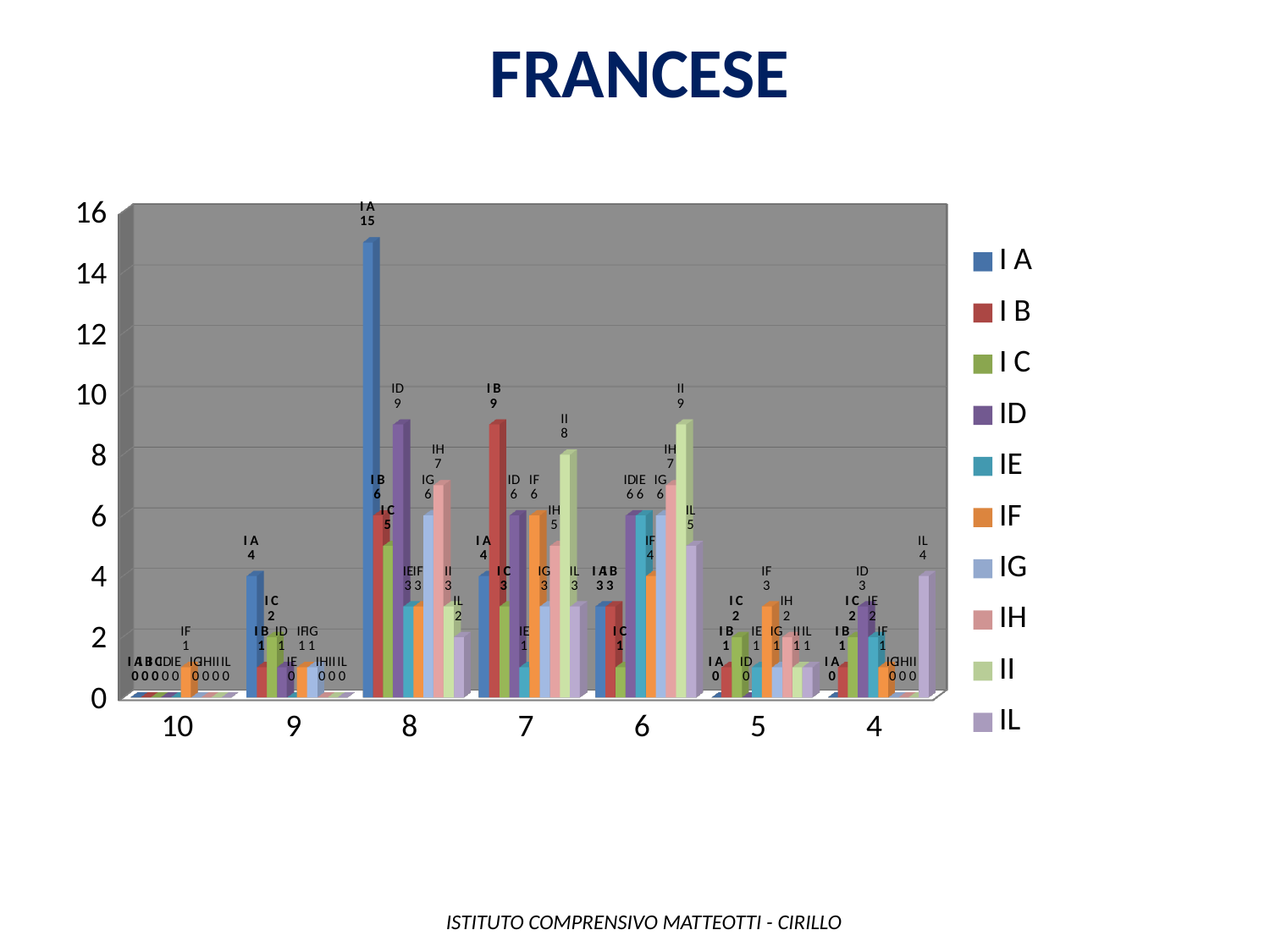
What is the value for series I A at category 8? 15 At category 7, which is larger: the value for I B or the value for ID? I B What type of chart is shown on the slide? bar chart What is the value for series I B at category 7? 9 Which series has the highest value at category 8? I A At which category does series I A reach its highest value? 8 Is the value for I A at category 8 greater or less than 10? greater What is the value for series IL at category 4? 4 How many categories are shown on the x axis? 7 What is the difference between the I A value and the ID value at category 8? 6 What is the value for series II at category 6? 9 How many series does the legend list? 10